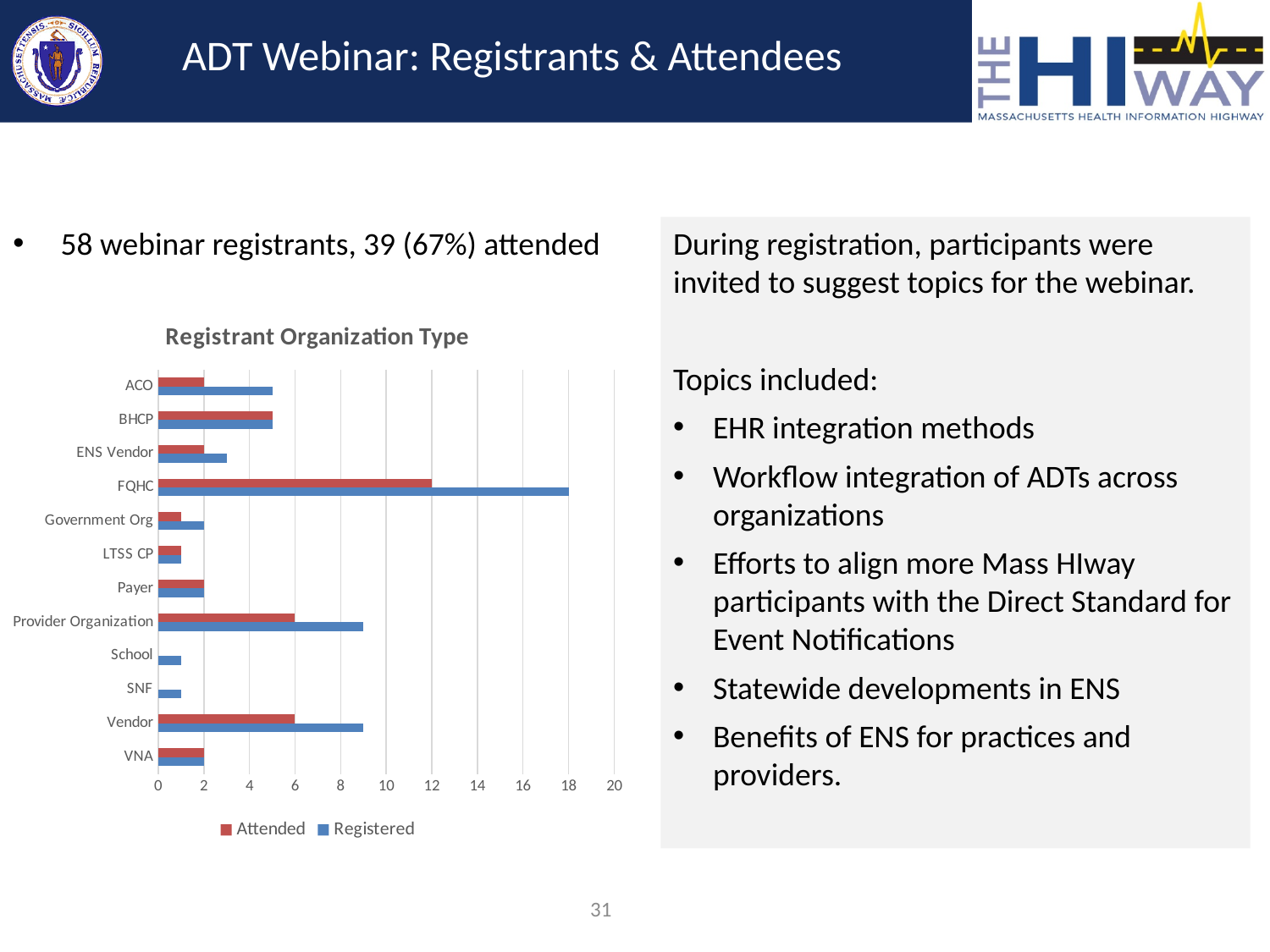
What colour represents the Attended series in the chart? red How many organization types are shown on the "Registrant Organization Type" chart? 12 What is the Attended value for Payer? 2 Which organization type has the highest Registered value? FQHC Which has a larger Registered value, Provider Organization or ENS Vendor? Provider Organization What is the Attended value for FQHC? 12 Is the Registered value for Provider Organization greater or less than 8? greater Which organization type has the highest Attended value? FQHC What is the Registered value for FQHC? 18 What kind of chart is the "Registrant Organization Type" chart? bar chart How many series does the legend of the "Registrant Organization Type" chart list? 2 What is the difference between the Registered and Attended values for FQHC? 6